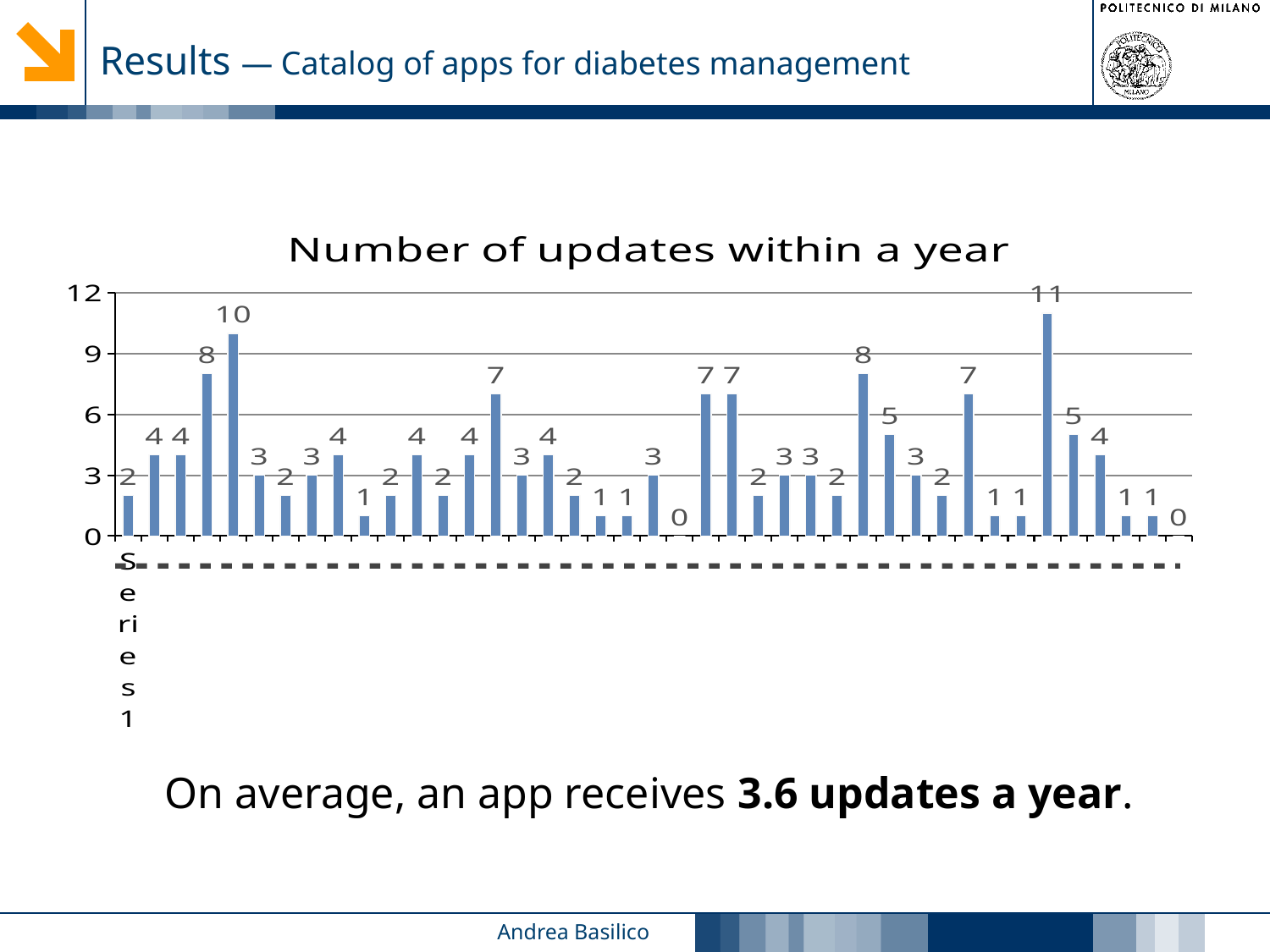
What is the title of the chart? Number of updates within a year What is the value of the second-highest bar in the chart? 10 How many series does the chart's legend list? 1 What is the highest value shown by any bar in the chart? 11 What is the difference between the highest and lowest bar values in the chart? 11 What is the value of the last (rightmost) bar in the chart? 0 What is the name of the series shown in the chart legend? Series1 What is the value of the first (leftmost) bar in the chart? 2 What kind of chart is shown on the slide? bar chart What is the lowest value shown by any bar in the chart? 0 What is the maximum value shown on the chart's vertical axis? 12 How many bars in the chart have a value of 0? 2